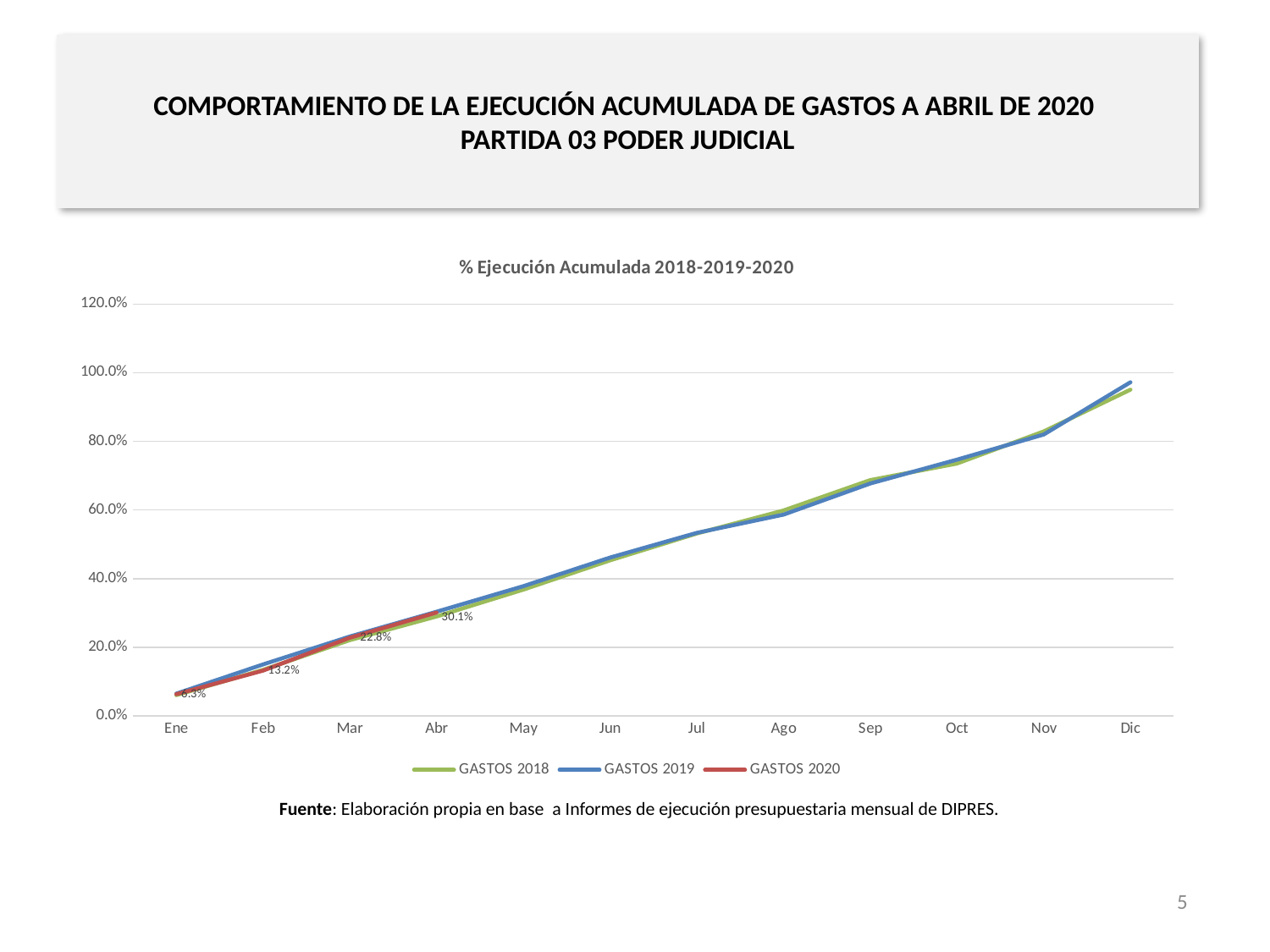
What is the value for GASTOS 2020 in Abr? 30.1% What is the value for GASTOS 2020 in Ene? 6.3% What is the value for GASTOS 2020 in Feb? 13.2% What kind of chart is shown on the slide? Line chart How many series does the legend list? 3 Is the value for GASTOS 2019 in Dic greater or less than 80.0%? greater Which is larger for GASTOS 2020: the value in Mar or the value in Feb? Mar What is the value for GASTOS 2020 in Mar? 22.8% Do the GASTOS 2019 values rise or fall from Ene to Dic? Rise What is the title of the chart? % Ejecución Acumulada 2018-2019-2020 How many months are shown on the x axis? 12 What is the difference between the GASTOS 2020 values for Abr and Mar? 7.3 percentage points